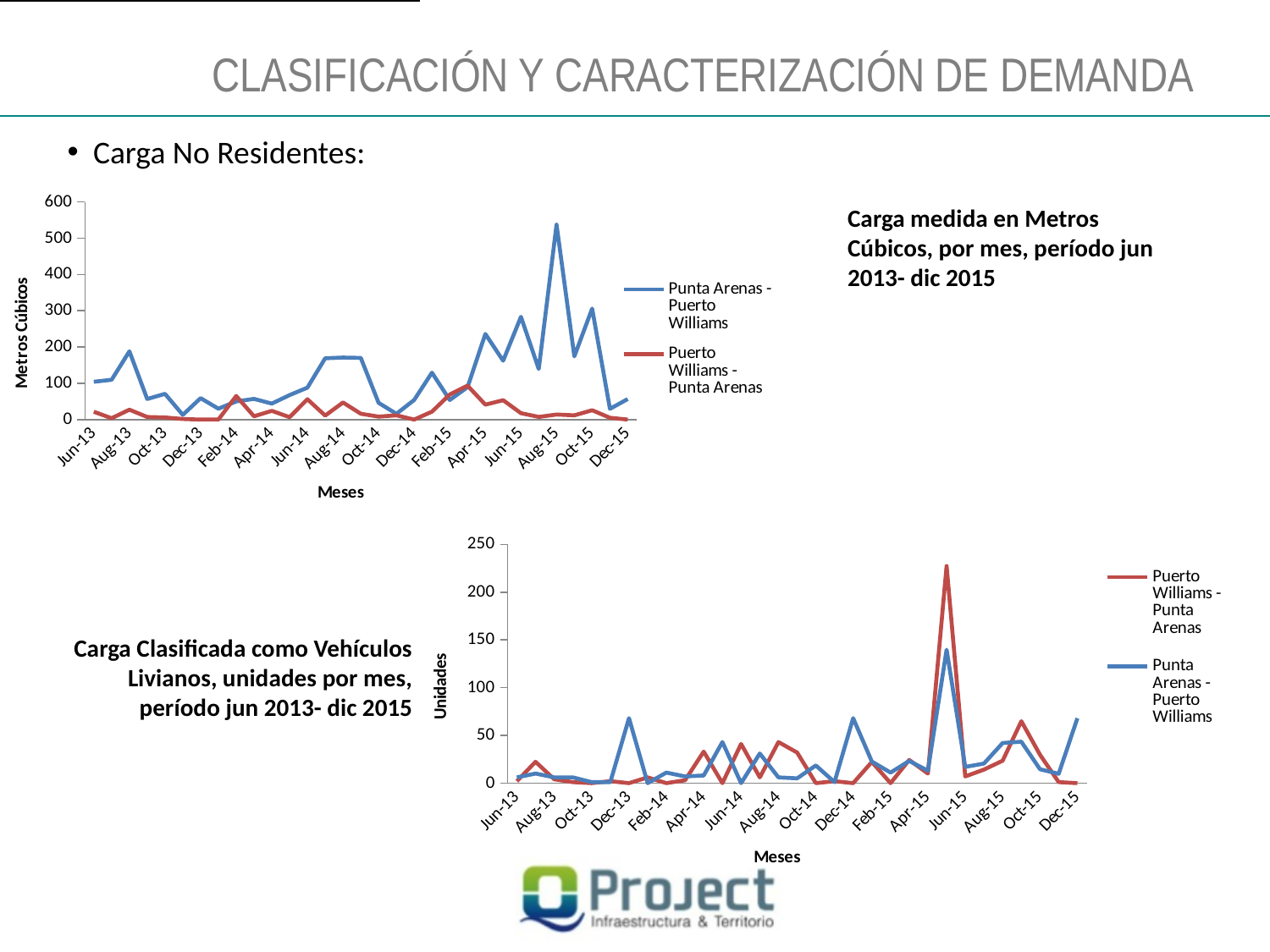
In the bottom chart (Unidades), in which month does the Puerto Williams - Punta Arenas series reach its highest value? May-15 In the bottom chart (Unidades), which series has the larger value in Jun-15, Puerto Williams - Punta Arenas or Punta Arenas - Puerto Williams? Punta Arenas - Puerto Williams How many series does the legend of the top chart (Metros Cúbicos) list? 2 In the top chart (Metros Cúbicos), which series has the larger value in Aug-15, Punta Arenas - Puerto Williams or Puerto Williams - Punta Arenas? Punta Arenas - Puerto Williams In the bottom chart (Unidades), is the value for Punta Arenas - Puerto Williams in Dec-13 greater or less than 50? greater What type of chart is the top chart (Metros Cúbicos)? Line chart In the top chart (Metros Cúbicos), is the value for Punta Arenas - Puerto Williams in Aug-15 greater or less than 500? greater What is the title of the vertical axis of the top chart? Metros Cúbicos What type of chart is the bottom chart (Unidades)? Line chart How many series does the legend of the bottom chart (Unidades) list? 2 In the top chart (Metros Cúbicos), in which month does the Punta Arenas - Puerto Williams series reach its highest value? Aug-15 In the bottom chart (Unidades), is the value for Puerto Williams - Punta Arenas in Jun-15 greater or less than 200? less